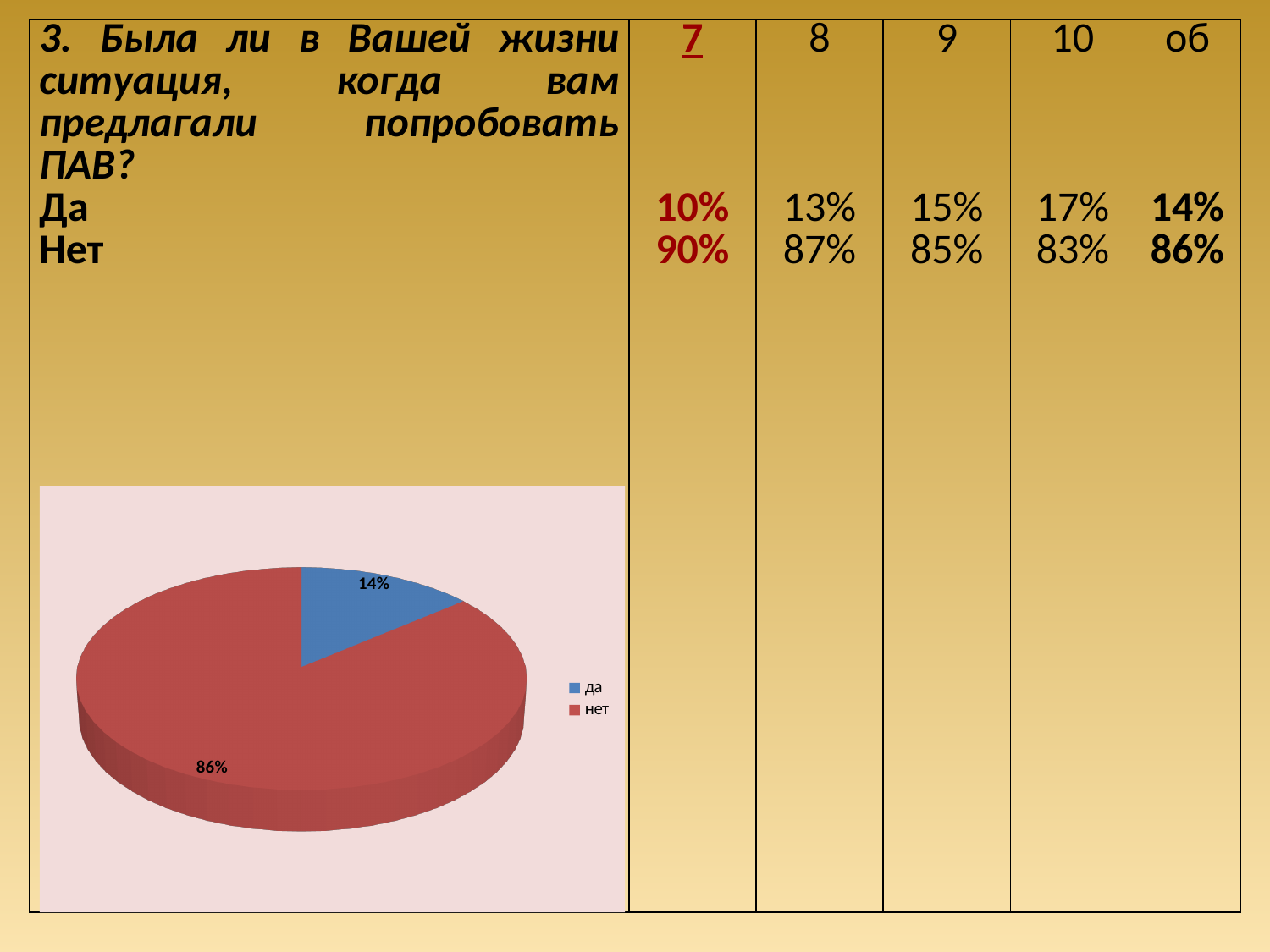
How many slices does the pie chart have? 2 What kind of chart is shown on the slide? pie chart Which slice of the pie chart is the largest? нет What is the difference between the "нет" and "да" shares in the pie chart? 72% What colour is the "да" slice in the pie chart? blue How many entries does the pie chart's legend list? 2 Which is larger in the pie chart, "да" or "нет"? нет What share of the pie chart is labelled "да"? 14% What colour is the "нет" slice in the pie chart? red What share of the pie chart is labelled "нет"? 86% Which slice of the pie chart is the smallest? да